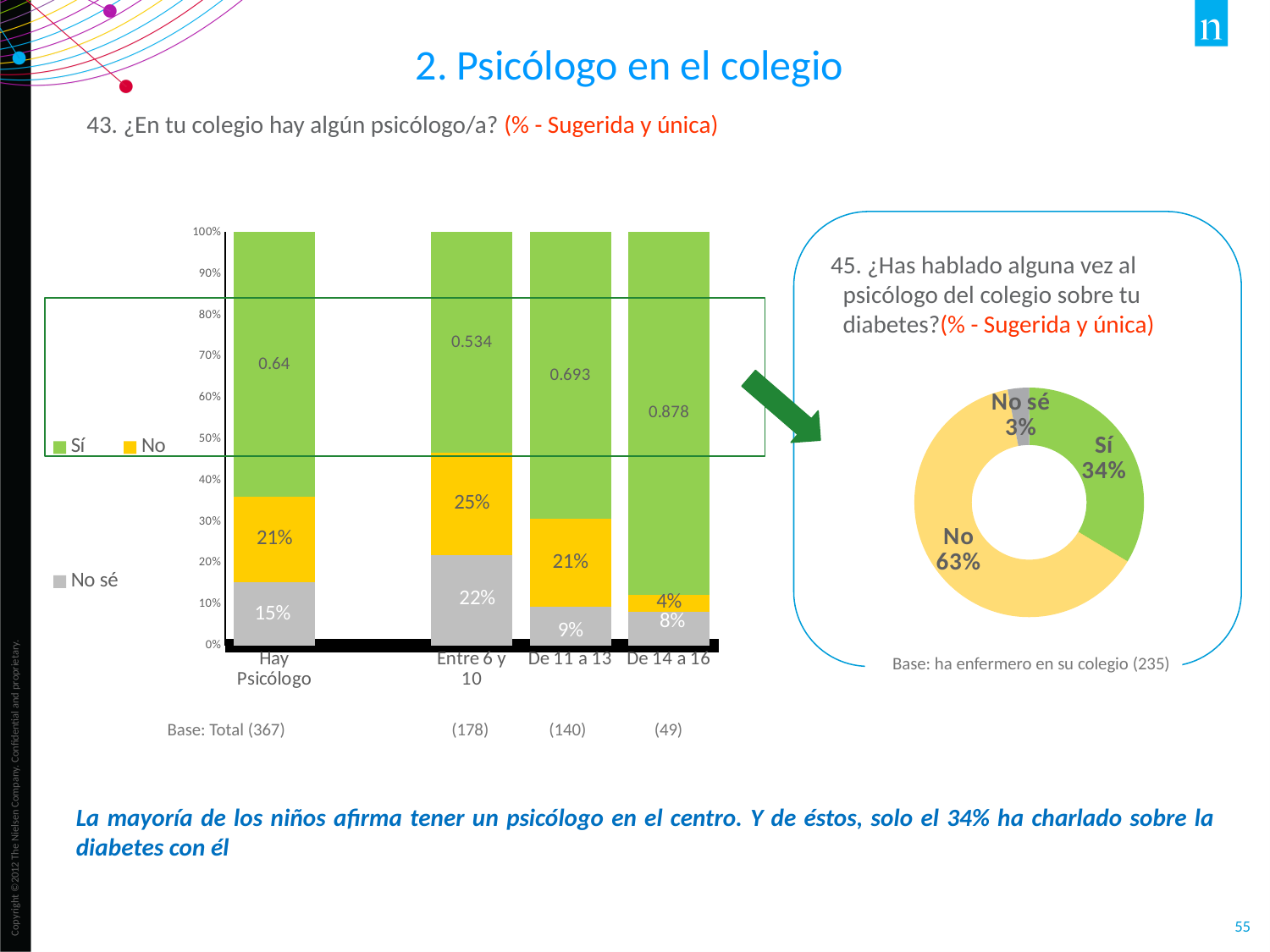
In the stacked bar chart on the left, which category has the lowest 'No' value? De 14 a 16 What kind of chart is shown on the right side of the slide, under question 45? Pie (donut) chart In the stacked bar chart on the left, is the 'No' value larger for 'Entre 6 y 10' or for 'De 11 a 13'? Entre 6 y 10 In the donut chart on the right, what share does the 'No' slice have? 63% In the stacked bar chart on the left, which category has the highest 'No sé' value? Entre 6 y 10 In the stacked bar chart on the left, what is the difference between the 'No sé' values for 'Entre 6 y 10' and 'De 11 a 13'? 13% In the stacked bar chart on the left, what is the 'No sé' value for the 'Hay Psicólogo' category? 15% In the donut chart on the right, which slice is the smallest? No sé In the stacked bar chart on the left, what label is printed on the 'Sí' segment for 'De 14 a 16'? 0.878 In the stacked bar chart on the left, what is the 'No' value for the 'Entre 6 y 10' category? 25% How many series does the legend of the stacked bar chart on the left list? 3 How many categories are shown on the x axis of the stacked bar chart on the left? 4